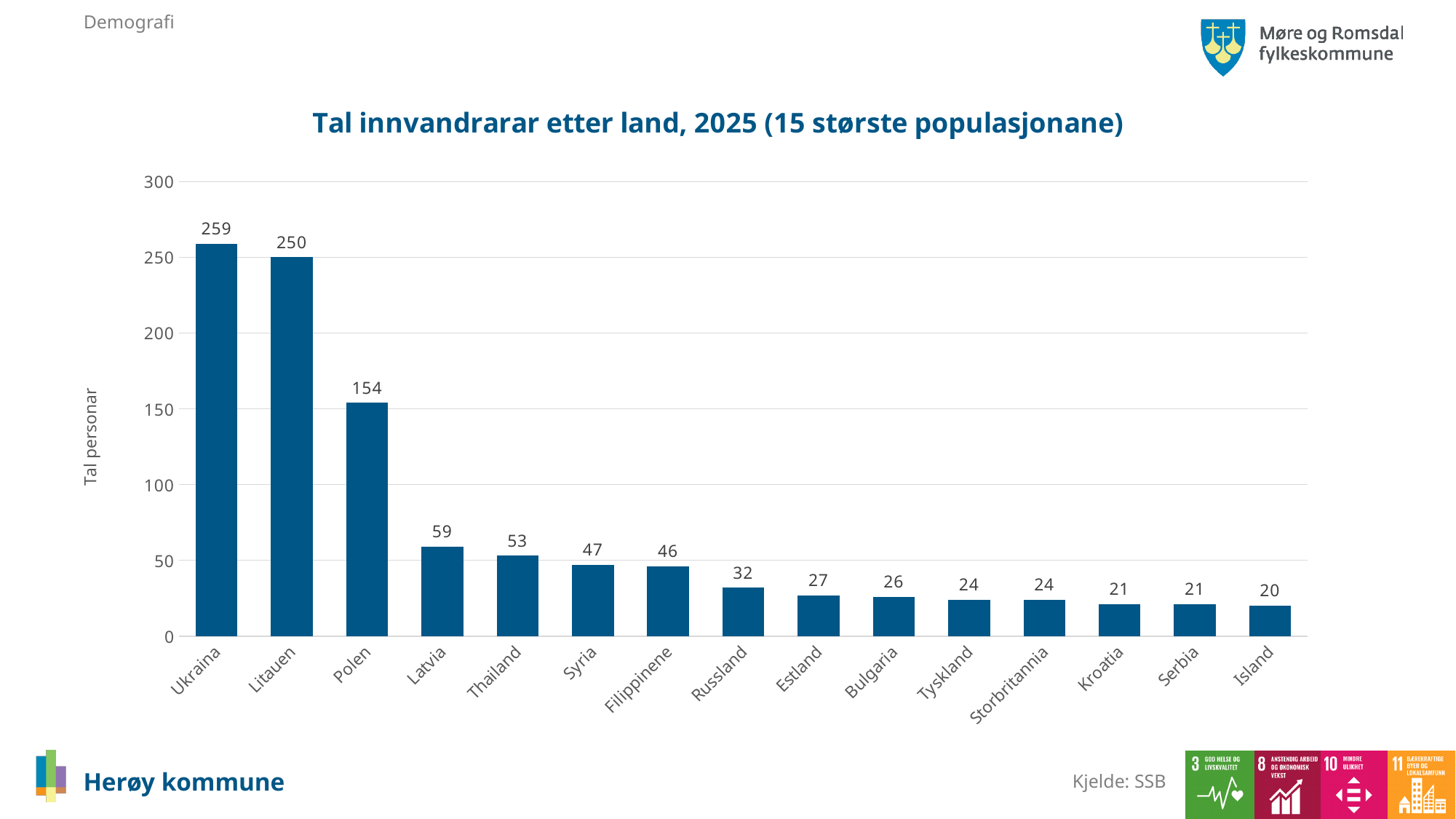
What is the value for Storbritannia? 24 What is the value for Thailand? 53 What kind of chart is this? bar chart What is the difference between the values for Polen and Latvia? 95 Which is larger, the value for Syria or the value for Russland? Syria What is the difference between the values for Ukraina and Litauen? 9 What is the title of the chart? Tal innvandrarar etter land, 2025 (15 største populasjonane) Which country has the lowest value? Island Is the value for Litauen greater or less than 200? greater What is the value for Polen? 154 How many countries are shown on the x axis? 15 Which country has the highest value? Ukraina